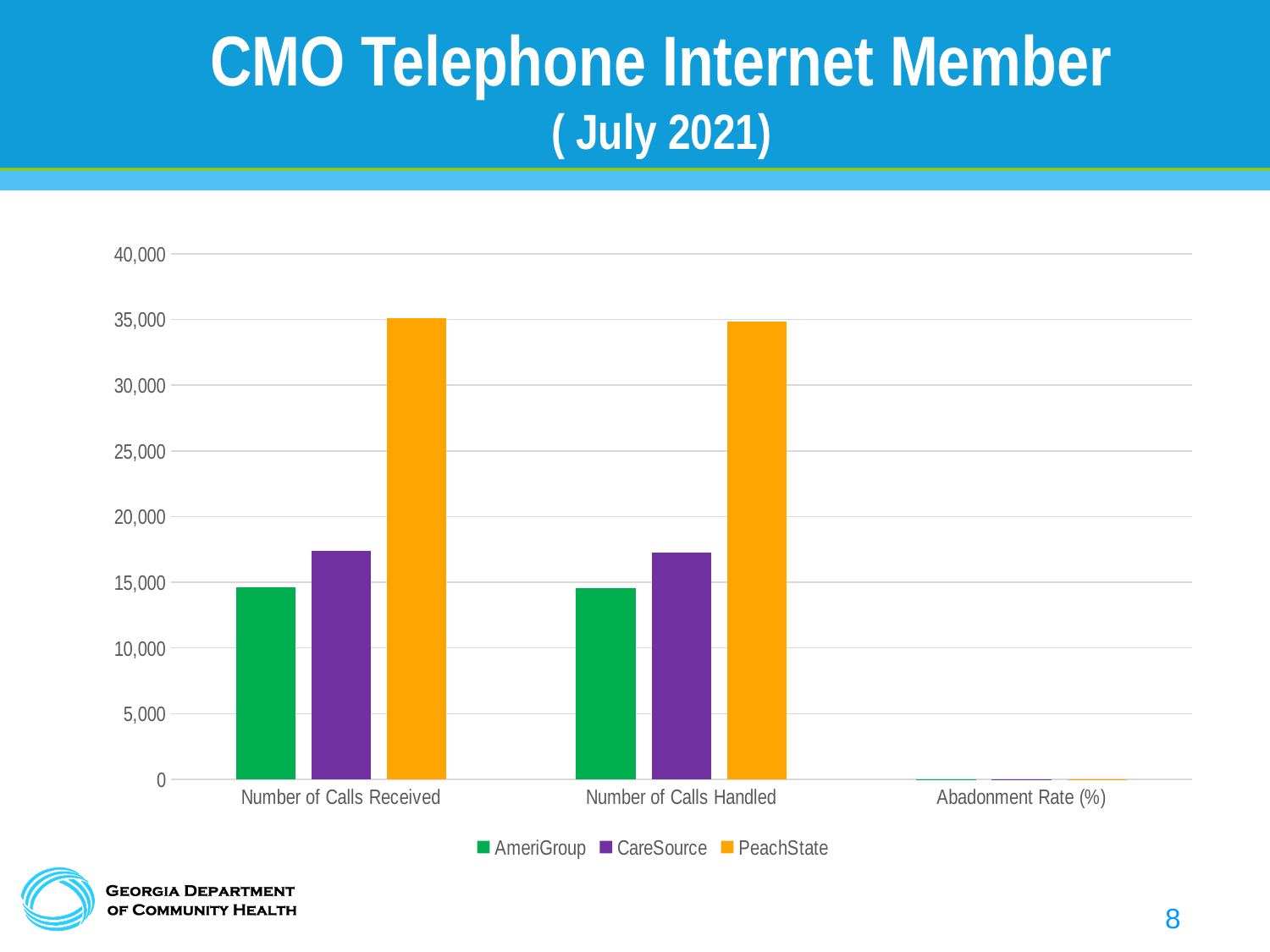
Is the value for PeachState in Number of Calls Handled greater or less than 30,000? greater For Number of Calls Received, which is larger: AmeriGroup or CareSource? CareSource Is the value for CareSource in Number of Calls Received greater or less than 20,000? less What is the title of the slide containing the chart? CMO Telephone Internet Member ( July 2021) How many series does the legend list? 3 Which series has the highest value for Number of Calls Received? PeachState How many categories are shown on the x axis? 3 Is the value for AmeriGroup in Number of Calls Handled greater or less than 20,000? less Which colour represents PeachState in the legend? orange What kind of chart is shown on the slide? bar chart Which series has the lowest value for Number of Calls Handled? AmeriGroup